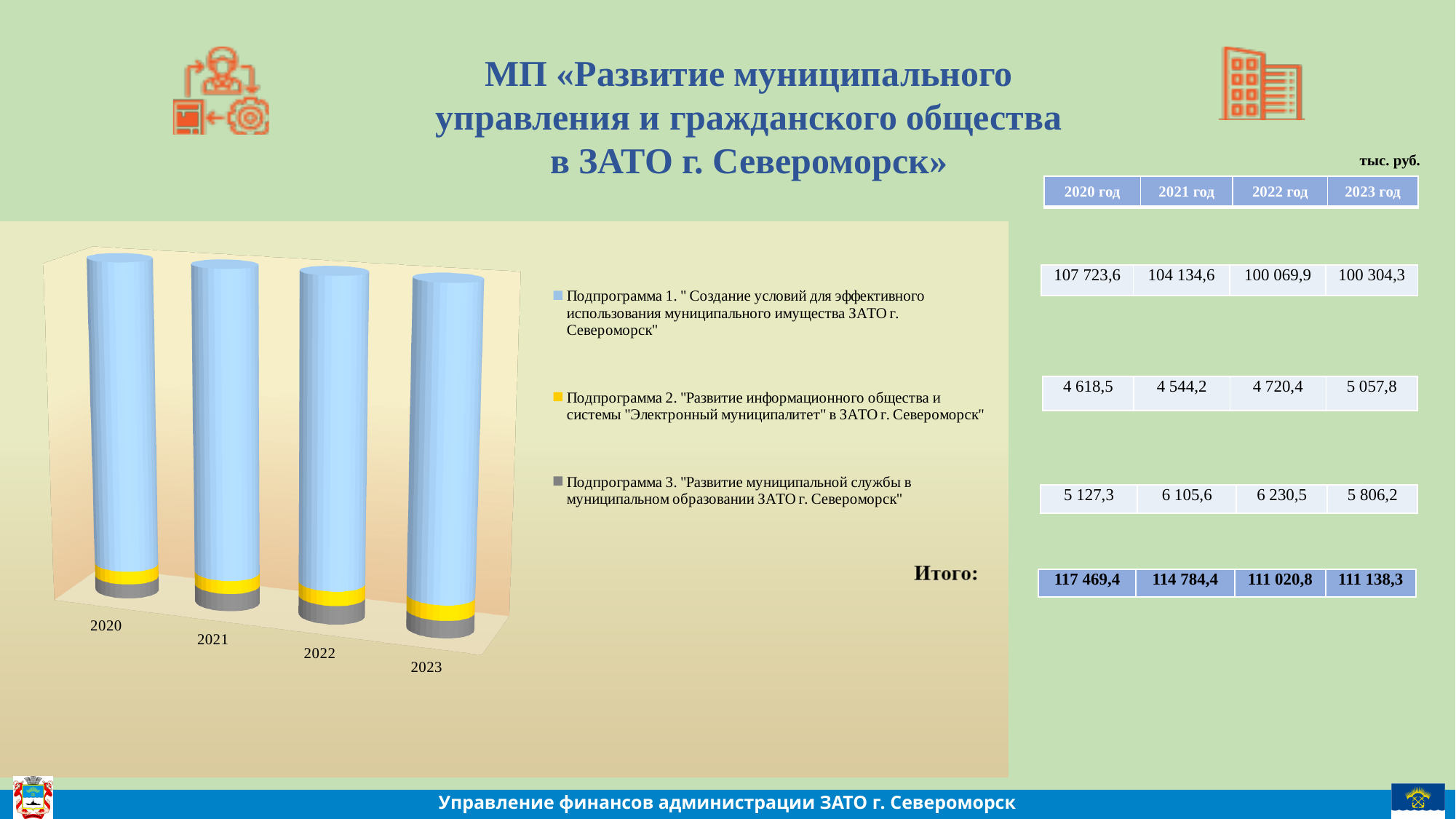
According to the table on the slide, what is the value for Подпрограмма 1 in 2020 год? 107 723,6 Does the value for Подпрограмма 1 rise or fall from 2020 to 2022? Fall What colour represents Подпрограмма 2 in the chart? Yellow In which year is the value for Подпрограмма 2 the lowest? 2021 год What is the difference between the Итого values for 2020 год and 2021 год? 2 685,0 According to the table on the slide, what is the Итого value for 2022 год? 111 020,8 According to the table on the slide, what is the value for Подпрограмма 2 in 2023 год? 5 057,8 How many years (categories) are plotted along the x axis of the chart? 4 What kind of chart is shown on the left of the slide? Stacked bar chart Which year has the highest total (Итого) value? 2020 год How many series does the chart legend list? 3 Is the value for Подпрограмма 3 larger in 2020 год or in 2021 год? 2021 год